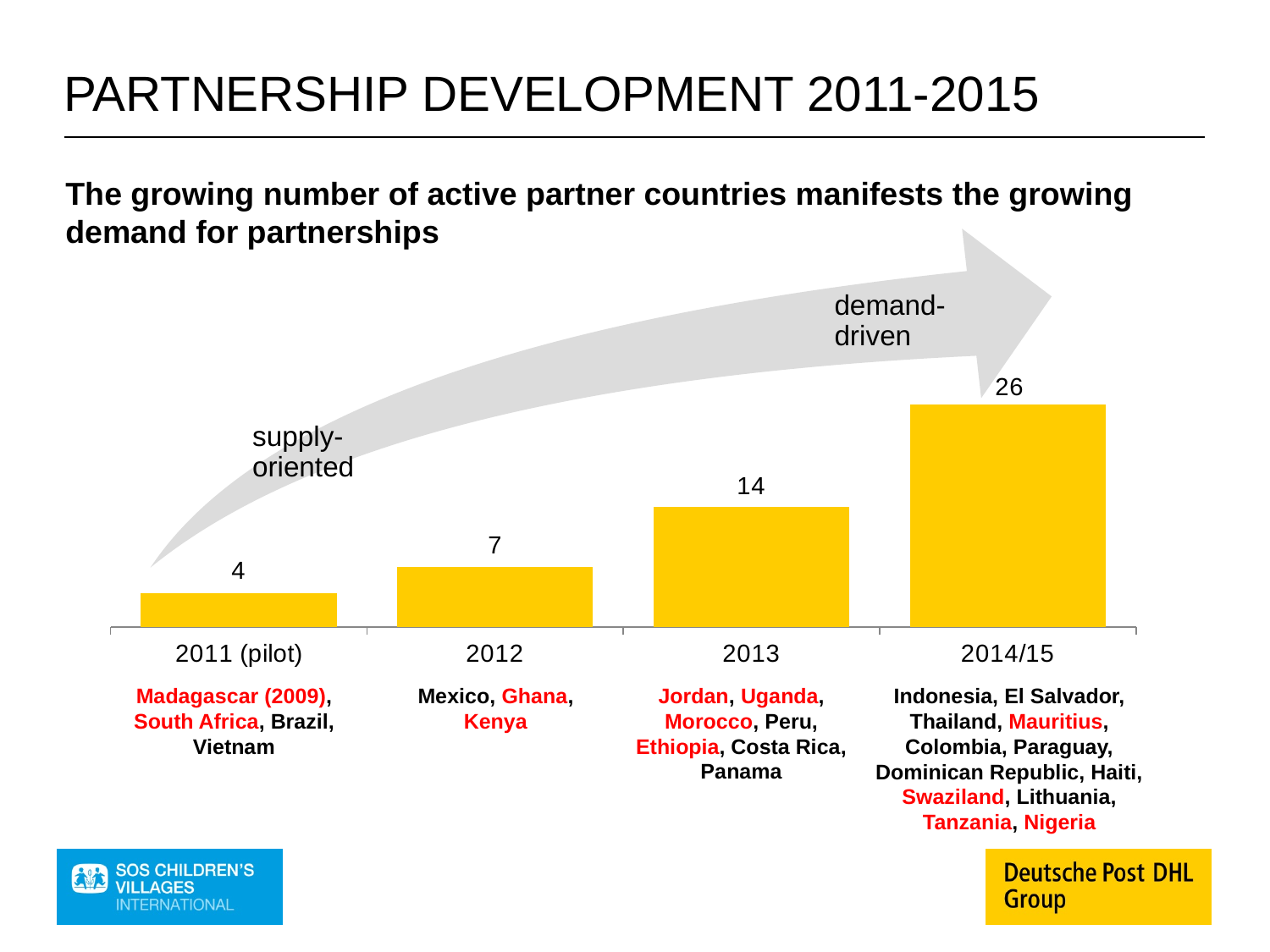
Which category has the highest value? 2014/15 Which is larger, the value for 2012 or the value for 2013? 2013 Which category has the lowest value? 2011 (pilot) What is the difference between the values for 2014/15 and 2013? 12 What is the value for 2013? 14 What is the difference between the values for 2012 and 2011 (pilot)? 3 What kind of chart is shown on the slide? bar chart What is the value for 2011 (pilot)? 4 How many categories are shown on the x axis? 4 What is the value for 2012? 7 Do the values rise or fall from 2011 (pilot) to 2014/15? rise What is the value for 2014/15? 26